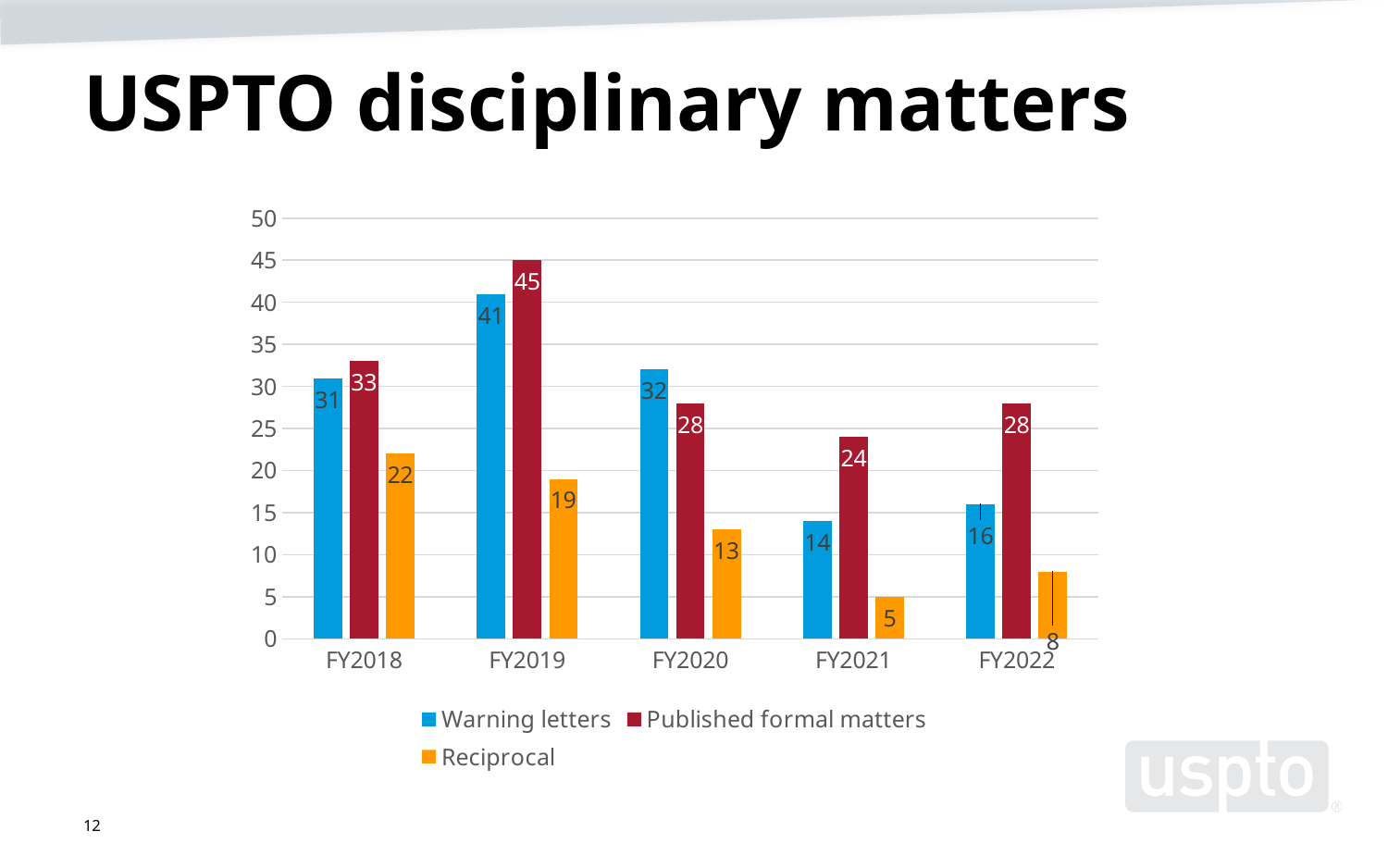
Which is larger in FY2020: Warning letters or Published formal matters? Warning letters Which fiscal year has the lowest value for Reciprocal? FY2021 How many fiscal years are shown on the x axis? 5 What kind of chart is shown on the slide? Bar chart What is the value for Reciprocal in FY2018? 22 What is the difference between Published formal matters and Warning letters in FY2022? 12 What is the title of the chart? USPTO disciplinary matters What is the value for Published formal matters in FY2019? 45 What is the value for Warning letters in FY2021? 14 How many series does the legend list? 3 Do the Reciprocal values rise or fall from FY2018 to FY2021? Fall Which fiscal year has the highest value for Warning letters? FY2019